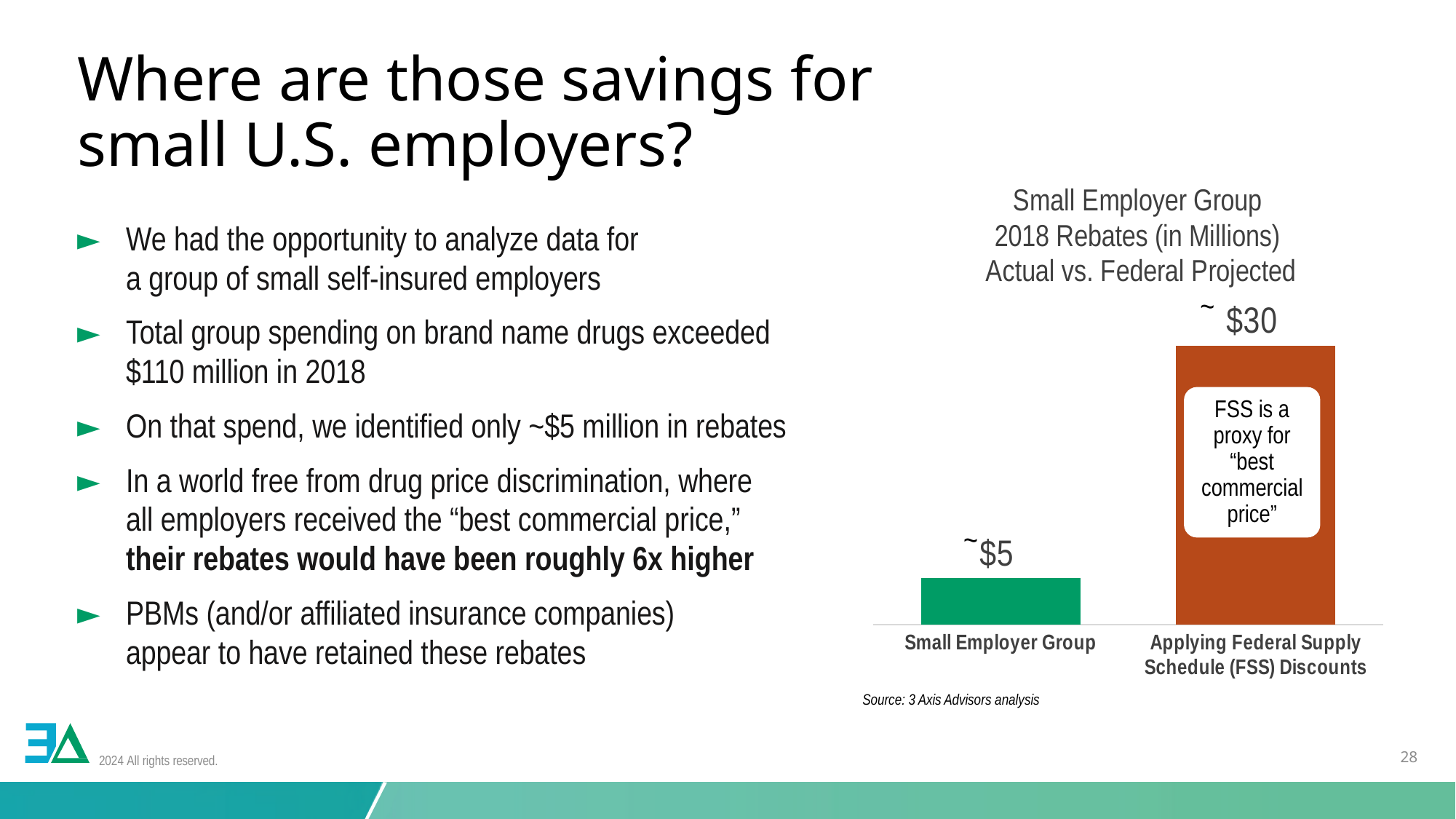
What kind of chart is shown on the slide? bar chart Which category has the higher rebate value in the chart? Applying Federal Supply Schedule (FSS) Discounts What is the title of the chart? Small Employer Group 2018 Rebates (in Millions) Actual vs. Federal Projected What is the data label shown for the Small Employer Group bar? ~$5 Is the value for Small Employer Group larger or smaller than the value for Applying Federal Supply Schedule (FSS) Discounts? smaller What does the callout inside the orange bar say? FSS is a proxy for "best commercial price" How many bars are plotted in the chart? 2 What is the data label shown for the Applying Federal Supply Schedule (FSS) Discounts bar? ~$30 Which category has the lower rebate value in the chart? Small Employer Group